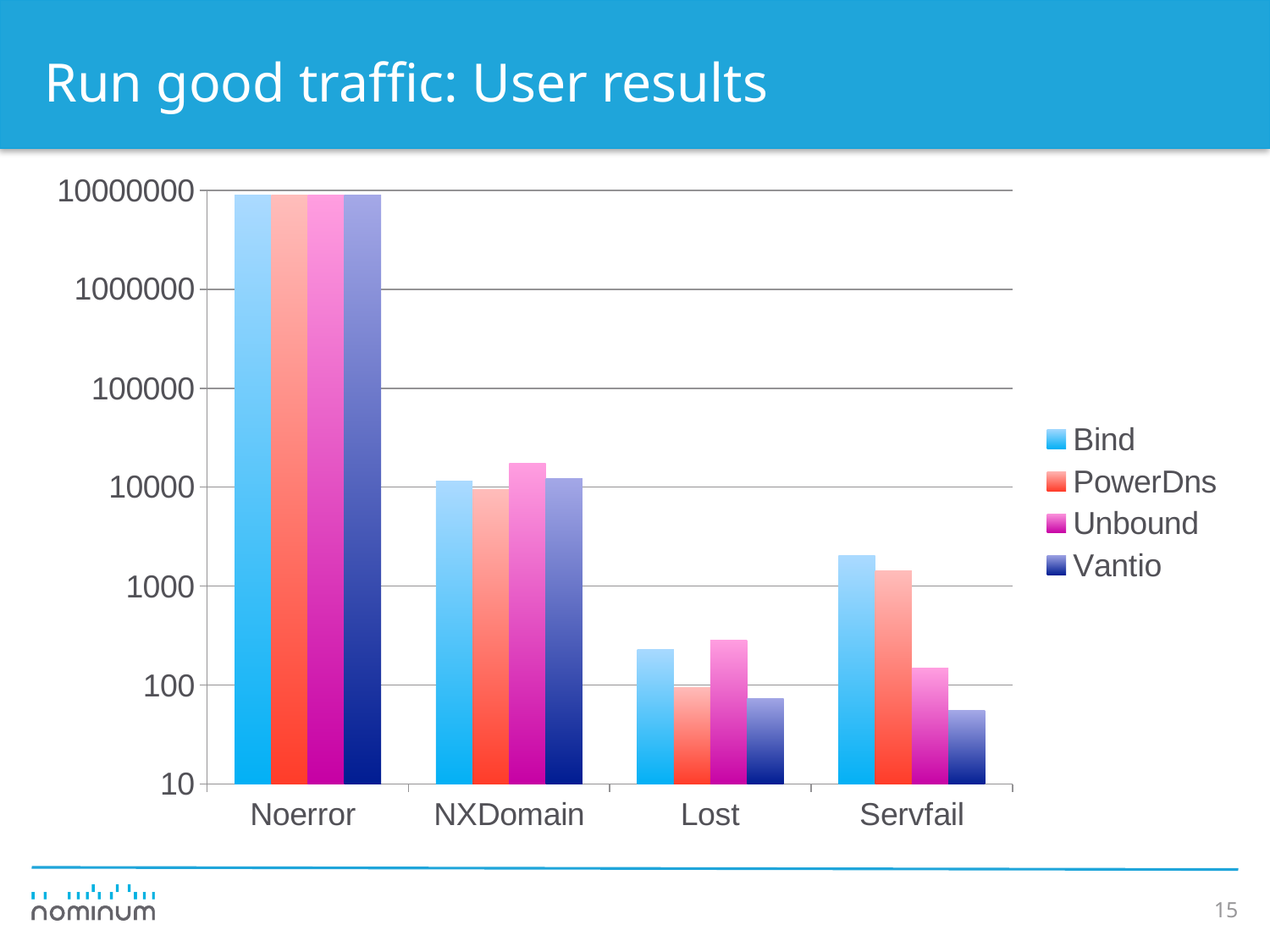
What kind of chart is shown on the slide? bar chart Is the value for Vantio in the Servfail category greater or less than 100? less Which series has the lowest value in the Lost category? Vantio In the Lost category, which is larger, Unbound or Vantio? Unbound Is the value for Unbound in the NXDomain category greater or less than 10000? greater How many categories are shown on the x axis? 4 What is the title of the slide? Run good traffic: User results Is the value for Vantio in the Lost category greater or less than 100? less Which series has the highest value in the Servfail category? Bind How many series does the legend list? 4 Which series is shown in magenta in the legend? Unbound